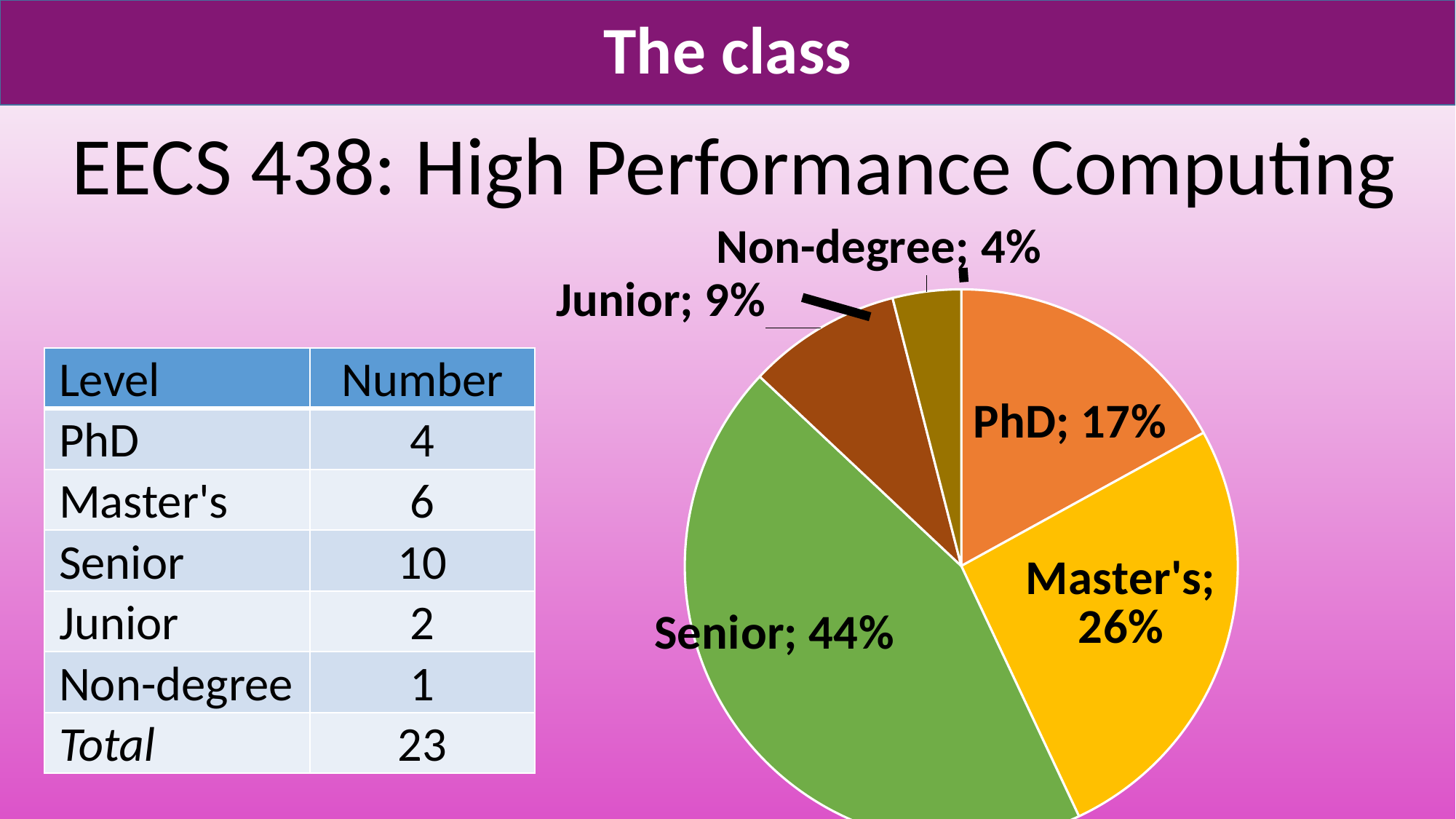
How many slices does the pie chart have? 5 What is the difference in percentage points between the Senior and Master's slices of the pie chart? 18 Which slice of the pie chart is the smallest? Non-degree What colour is the Senior slice of the pie chart? green Which slice is larger in the pie chart, Master's or PhD? Master's What percentage of the pie chart is labelled for Junior? 9% What percentage of the pie chart is labelled for Senior? 44% What percentage of the pie chart is labelled for Non-degree? 4% What percentage of the pie chart is labelled for Master's? 26% Which slice of the pie chart is the largest? Senior What percentage of the pie chart is labelled for PhD? 17% What kind of chart is shown on the slide? pie chart